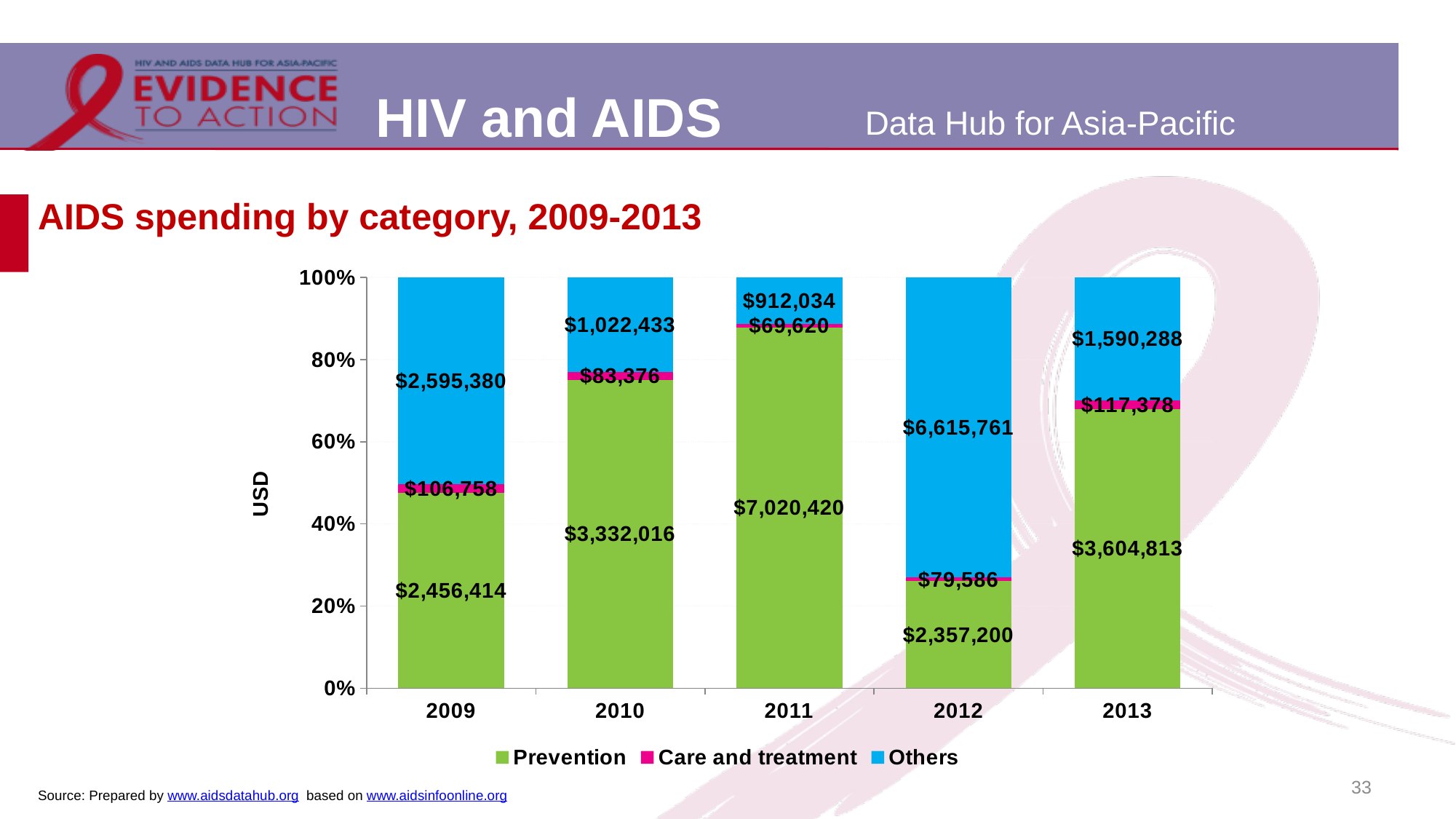
What was the Care and treatment spending in 2013? $117,378 Which was larger in 2009, Prevention spending or Others spending? Others Which year had the lowest Care and treatment spending? 2011 What was the total AIDS spending across all three categories in 2013? $5,312,479 Which year had the highest Prevention spending? 2011 What was the Others spending in 2012? $6,615,761 Is the Prevention share of spending in 2011 greater or less than 80%? greater How much more was spent on Prevention in 2011 than in 2010? $3,688,404 How many series does the legend list? 3 What was the Prevention spending in 2011? $7,020,420 What kind of chart is shown on the slide? Stacked bar chart How many years are shown on the x axis? 5